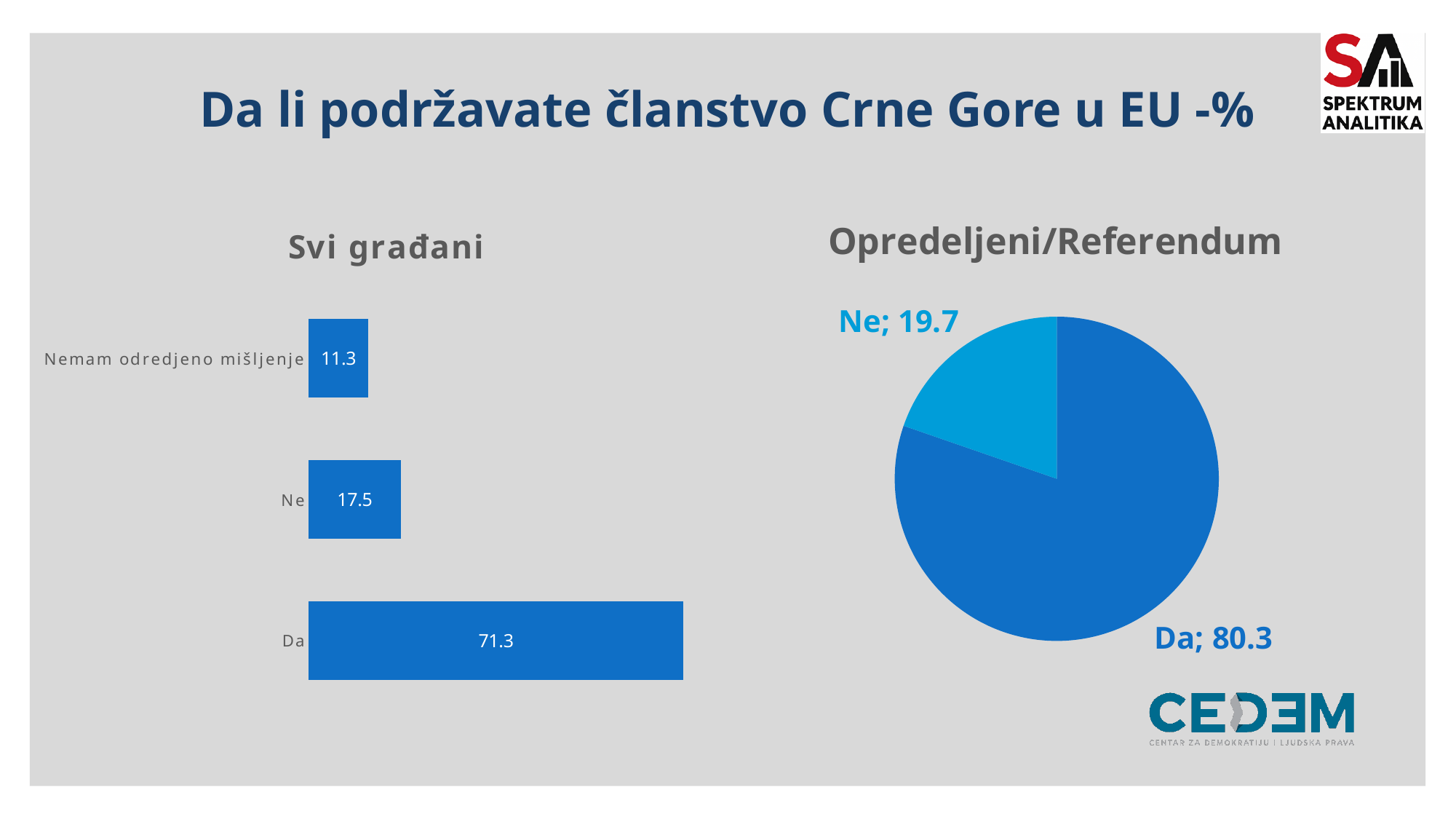
In the 'Svi građani' chart, what is the value for 'Da'? 71.3 In the 'Svi građani' chart, what is the value for 'Nemam odredjeno mišljenje'? 11.3 In the 'Svi građani' chart, what is the difference between the values for 'Da' and 'Ne'? 53.8 In the 'Svi građani' chart, which category has the highest value? Da In the 'Opredeljeni/Referendum' chart, what is the value for 'Ne'? 19.7 In the 'Opredeljeni/Referendum' chart, which slice is larger, 'Da' or 'Ne'? Da In the 'Svi građani' chart, how many categories are shown? 3 In the 'Opredeljeni/Referendum' chart, what is the value for 'Da'? 80.3 What kind of chart is the 'Opredeljeni/Referendum' chart? Pie chart In the 'Svi građani' chart, which category has the lowest value? Nemam odredjeno mišljenje In the 'Svi građani' chart, what is the value for 'Ne'? 17.5 What kind of chart is the 'Svi građani' chart? Bar chart